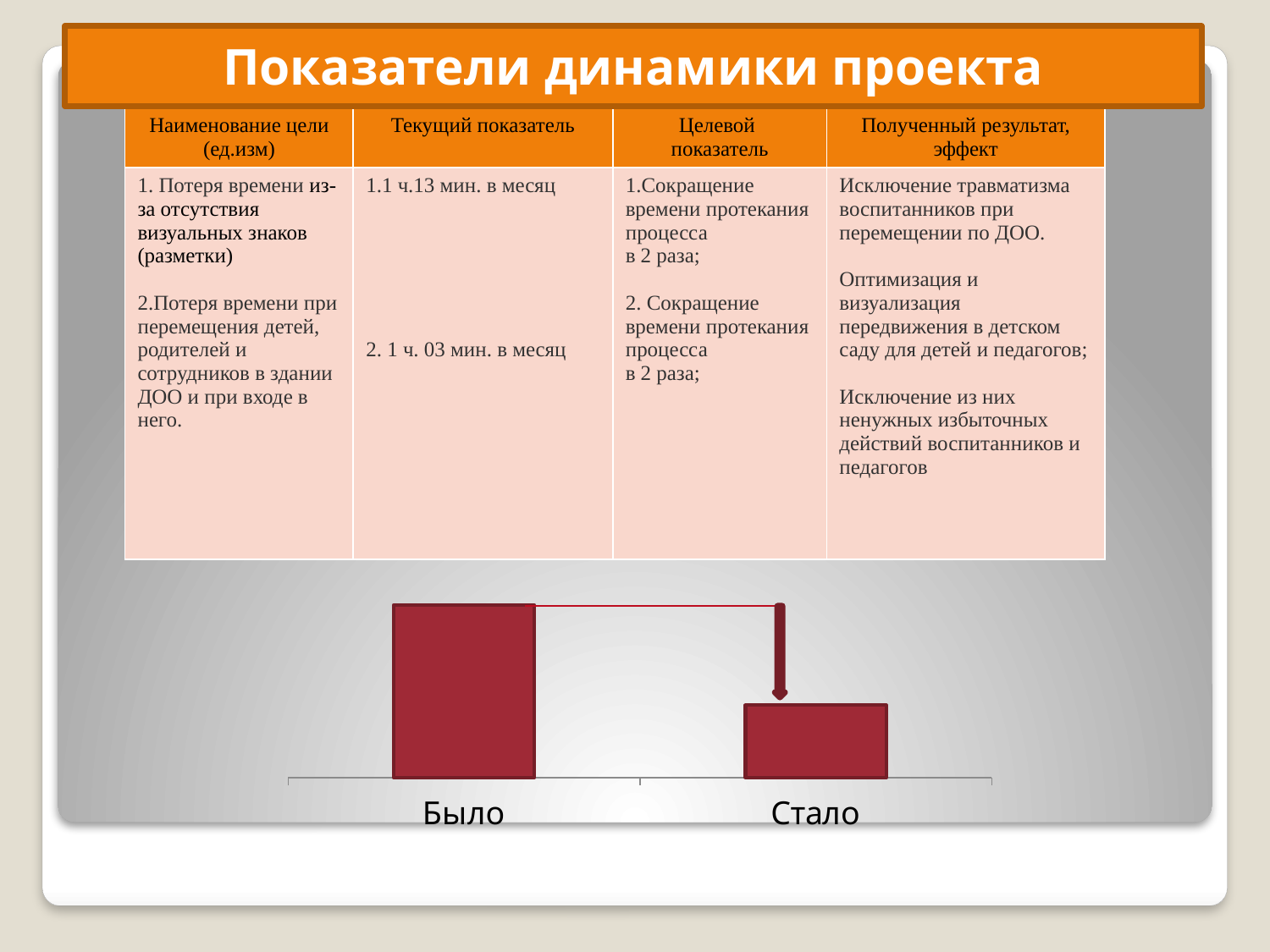
What are the two category labels on the x axis of the bar chart? Было, Стало Do the values on the bar chart rise or fall from Было to Стало? fall Which category on the bar chart has the lowest value? Стало How many categories are plotted on the bar chart? 2 Which category on the bar chart has the highest value? Было What colour are the bars on the bar chart? dark red On the bar chart, which is larger: the value for Было or the value for Стало? Было What kind of chart is shown at the bottom of the slide? bar chart